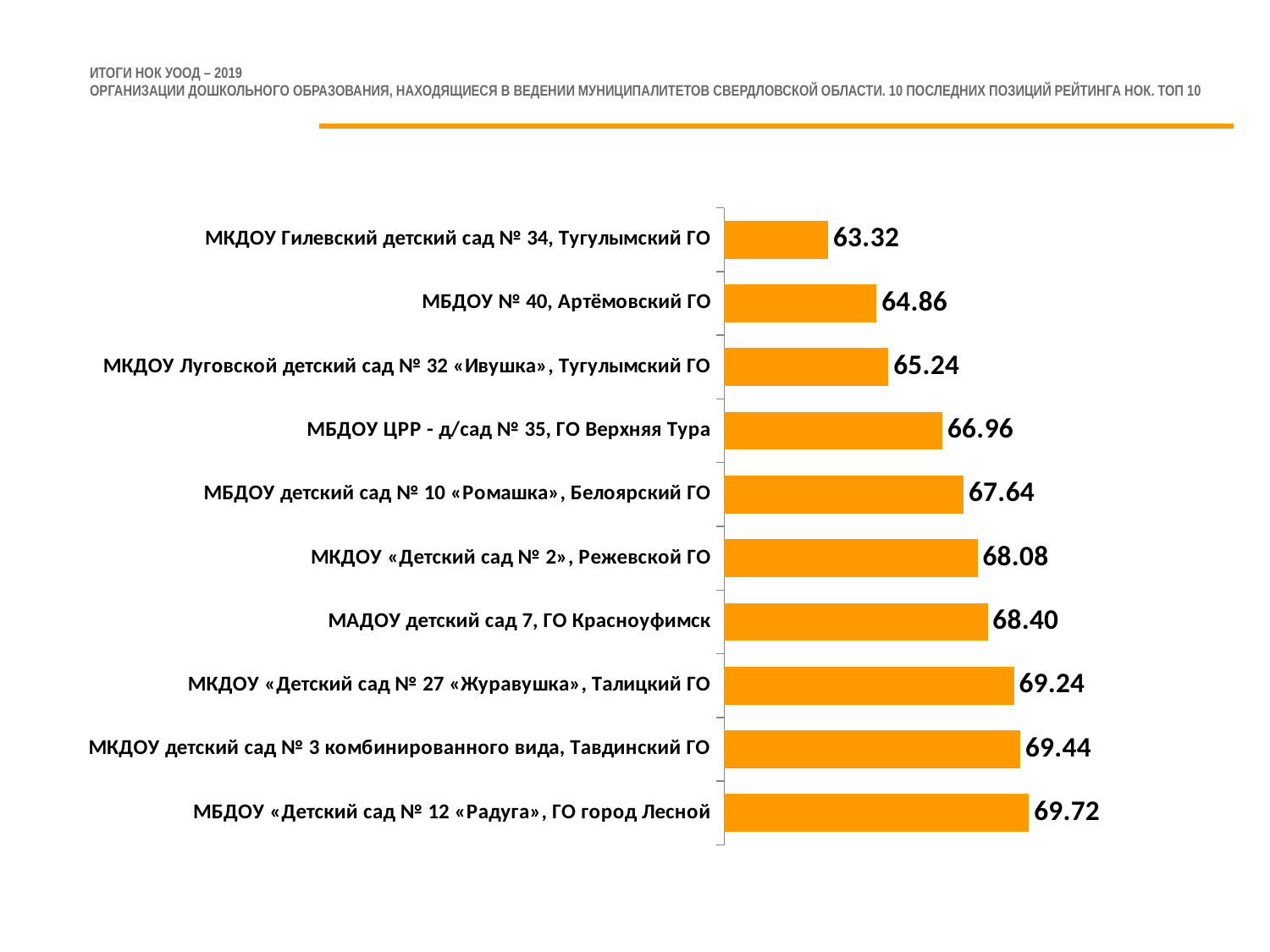
What is the difference between the values for МКДОУ «Детский сад № 2», Режевской ГО and МБДОУ детский сад № 10 «Ромашка», Белоярский ГО? 0.44 How many organisations are shown on the chart? 10 Which has a larger value: МКДОУ Луговской детский сад № 32 «Ивушка», Тугулымский ГО or МКДОУ «Детский сад № 27 «Журавушка», Талицкий ГО? МКДОУ «Детский сад № 27 «Журавушка», Талицкий ГО What value is shown for МБДОУ № 40, Артёмовский ГО? 64.86 Do the values increase or decrease going from the top bar to the bottom bar? Increase What is the difference between the values for МБДОУ «Детский сад № 12 «Радуга», ГО город Лесной and МКДОУ Гилевский детский сад № 34, Тугулымский ГО? 6.40 What value is shown for МБДОУ ЦРР - д/сад № 35, ГО Верхняя Тура? 66.96 What colour are the bars on the chart? Orange Which organisation has the lowest value on the chart? МКДОУ Гилевский детский сад № 34, Тугулымский ГО Which organisation has the highest value on the chart? МБДОУ «Детский сад № 12 «Радуга», ГО город Лесной What kind of chart is shown on the slide? Bar chart What value is shown for МАДОУ детский сад 7, ГО Красноуфимск? 68.40